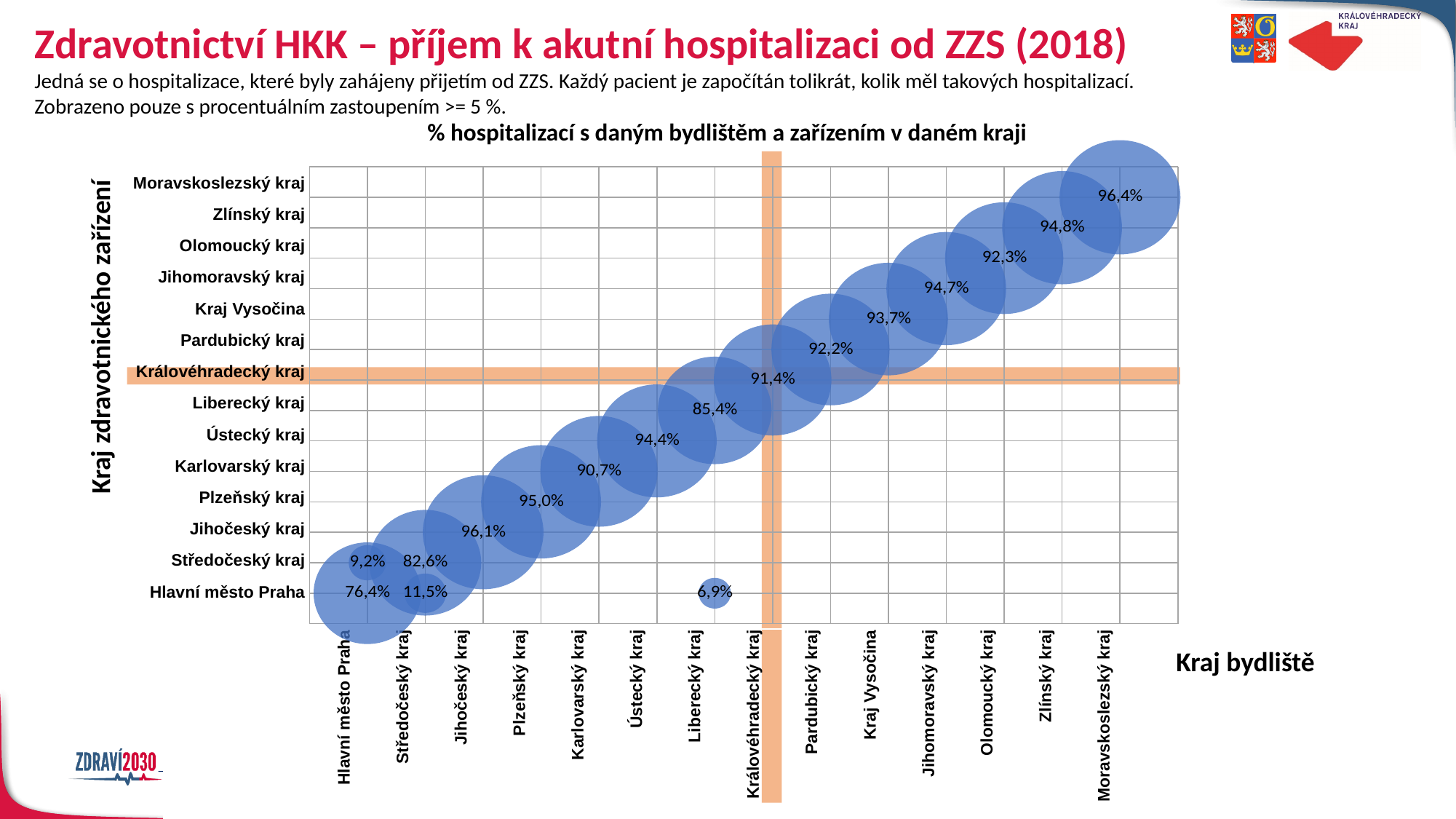
What percentage of hospitalizations of residents of Královéhradecký kraj took place in a facility in Královéhradecký kraj? 91,4% Which region of residence has the highest share of hospitalizations in a facility in the same region? Moravskoslezský kraj How many bubbles (data points) are plotted on the chart? 17 What percentage of hospitalizations of residents of Hlavní město Praha took place in a facility in Středočeský kraj? 9,2% Which region of residence has the lowest share of hospitalizations in a facility in the same region? Hlavní město Praha Which is larger: the same-region share for Liberecký kraj or for Pardubický kraj? Pardubický kraj What is the label of the x axis of the chart? Kraj bydliště What type of chart is shown on the slide? bubble chart What percentage of hospitalizations of residents of Moravskoslezský kraj took place in a facility in Moravskoslezský kraj? 96,4% How many regions of residence are listed on the x axis? 14 What percentage of hospitalizations of residents of Liberecký kraj took place in a facility in Hlavní město Praha? 6,9% What is the difference between the same-region share for Jihočeský kraj (96,1%) and for Středočeský kraj (82,6%)? 13,5 percentage points